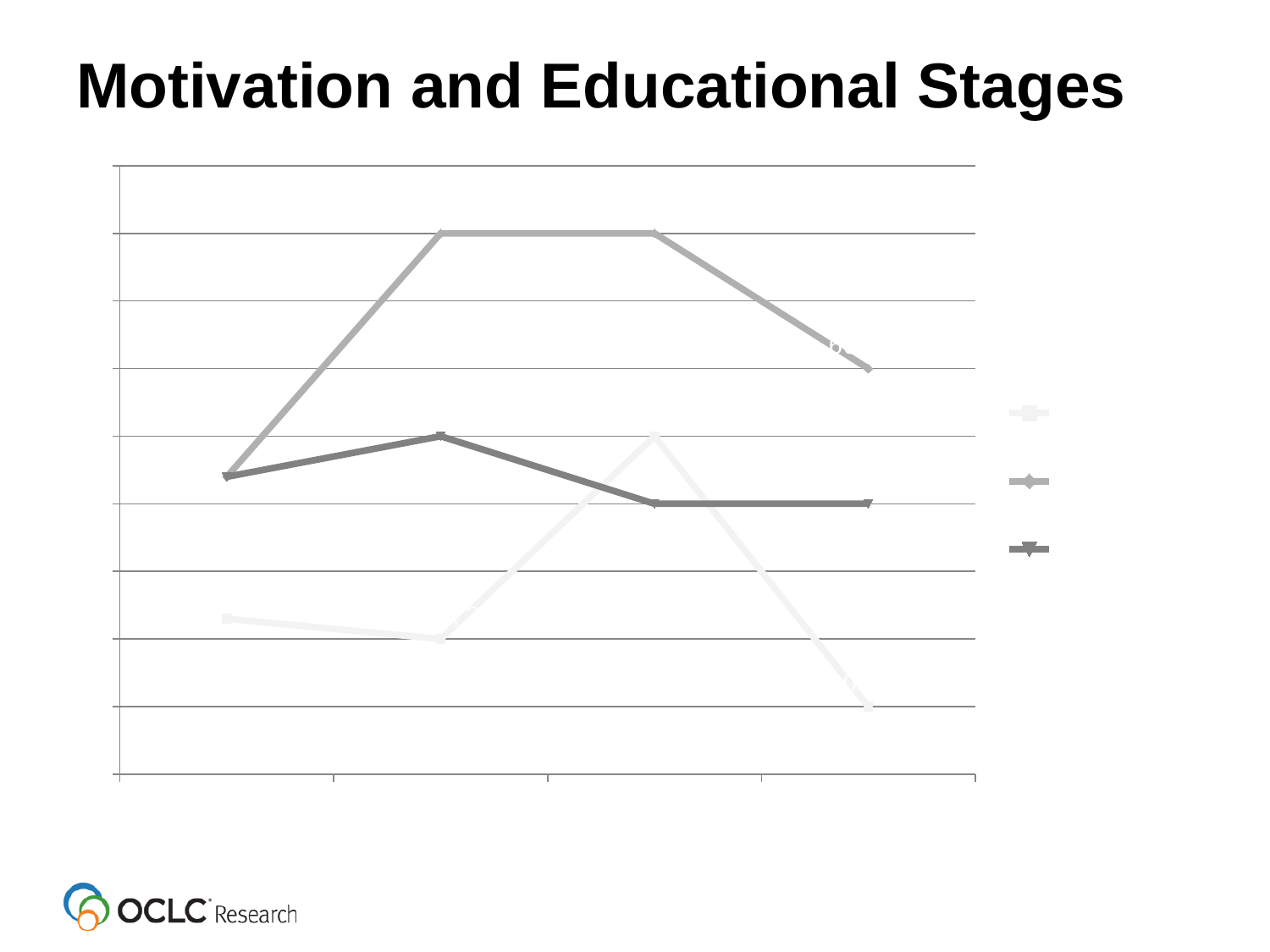
Which line reaches the lowest point on the chart: the lightest line, the medium-grey line, or the dark-grey line? the lightest line How many points are plotted along the x axis for each line? 4 Which line reaches the highest point on the chart: the lightest line, the medium-grey line, or the dark-grey line? the medium-grey line At the fourth x-axis point, which is higher: the medium-grey line or the dark-grey line? the medium-grey line Does the dark-grey line with triangle markers rise or fall between its second and third points? fall How many series does the legend list? 3 Where is the legend positioned relative to the plot area? to the right What kind of chart is shown on the slide? line chart Does the medium-grey line with diamond markers rise or fall between its first and second points? rise Does the lightest (palest) line rise or fall between its third and fourth points? fall What is the title of the slide containing the chart? Motivation and Educational Stages